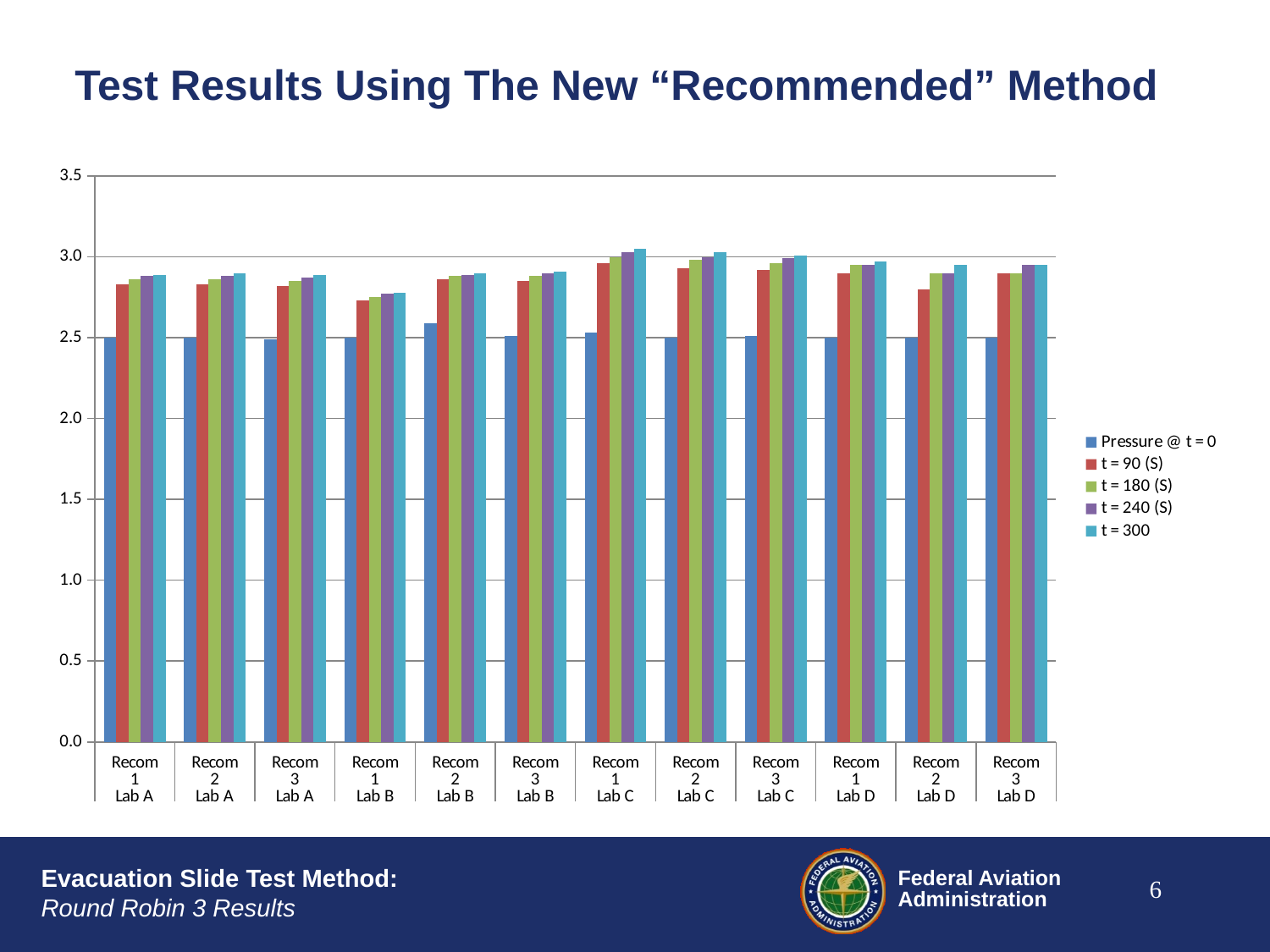
Is the value of t = 90 (S) for Recom 1 Lab B greater or less than 3.0? less Which legend entry is listed first? Pressure @ t = 0 How many categories are shown along the x axis? 12 Within the Recom 1 Lab B group, do the values rise or fall from Pressure @ t = 0 to t = 300? rise How many series does the legend list? 5 What kind of chart is shown on the slide? bar chart What is the title of the chart on the slide? Test Results Using The New "Recommended" Method Which category has the lowest t = 90 (S) value? Recom 1 Lab B Which is larger, the t = 90 (S) value for Recom 1 Lab B or for Recom 1 Lab C? Recom 1 Lab C Which category has the lowest t = 300 value? Recom 1 Lab B Is the value of t = 90 (S) for Recom 1 Lab B greater or less than 2.5? greater Is the value of Pressure @ t = 0 for Recom 2 Lab B greater or less than 2.5? greater